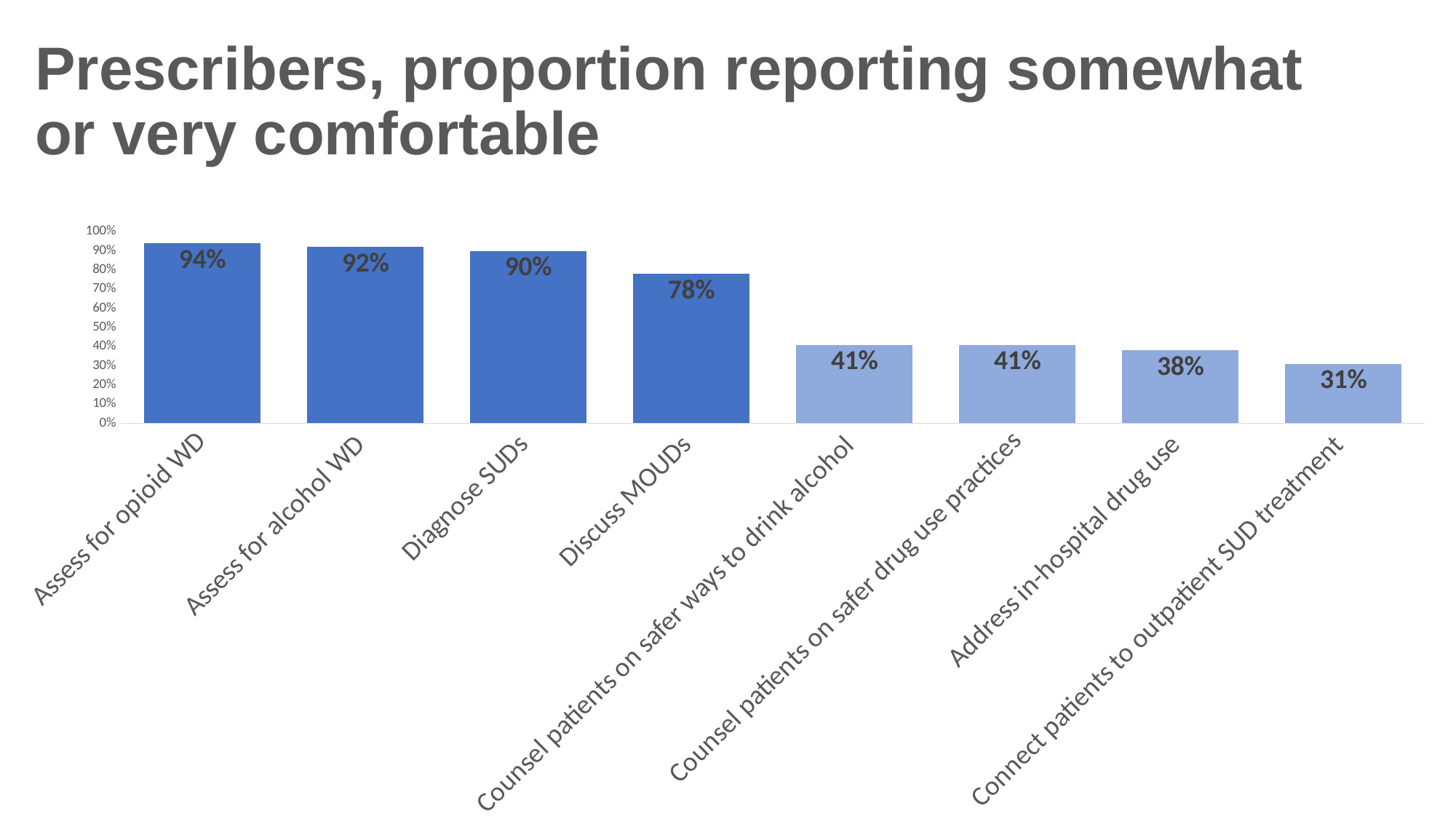
Which category has the highest value? Assess for opioid WD What kind of chart is shown on the slide? Bar chart What is the value shown for 'Address in-hospital drug use'? 38% What is the value shown for 'Connect patients to outpatient SUD treatment'? 31% What is the difference between the values for 'Assess for opioid WD' and 'Connect patients to outpatient SUD treatment'? 63% How many categories are shown in the chart? 8 Is the value for 'Counsel patients on safer drug use practices' greater or less than 50%? less Do the values rise or fall from left to right along the x axis? Fall Which is larger, the value for 'Diagnose SUDs' or the value for 'Discuss MOUDs'? Diagnose SUDs Which category has the lowest value? Connect patients to outpatient SUD treatment What is the value shown for 'Discuss MOUDs'? 78% What proportion of prescribers reported being somewhat or very comfortable with 'Assess for opioid WD'? 94%